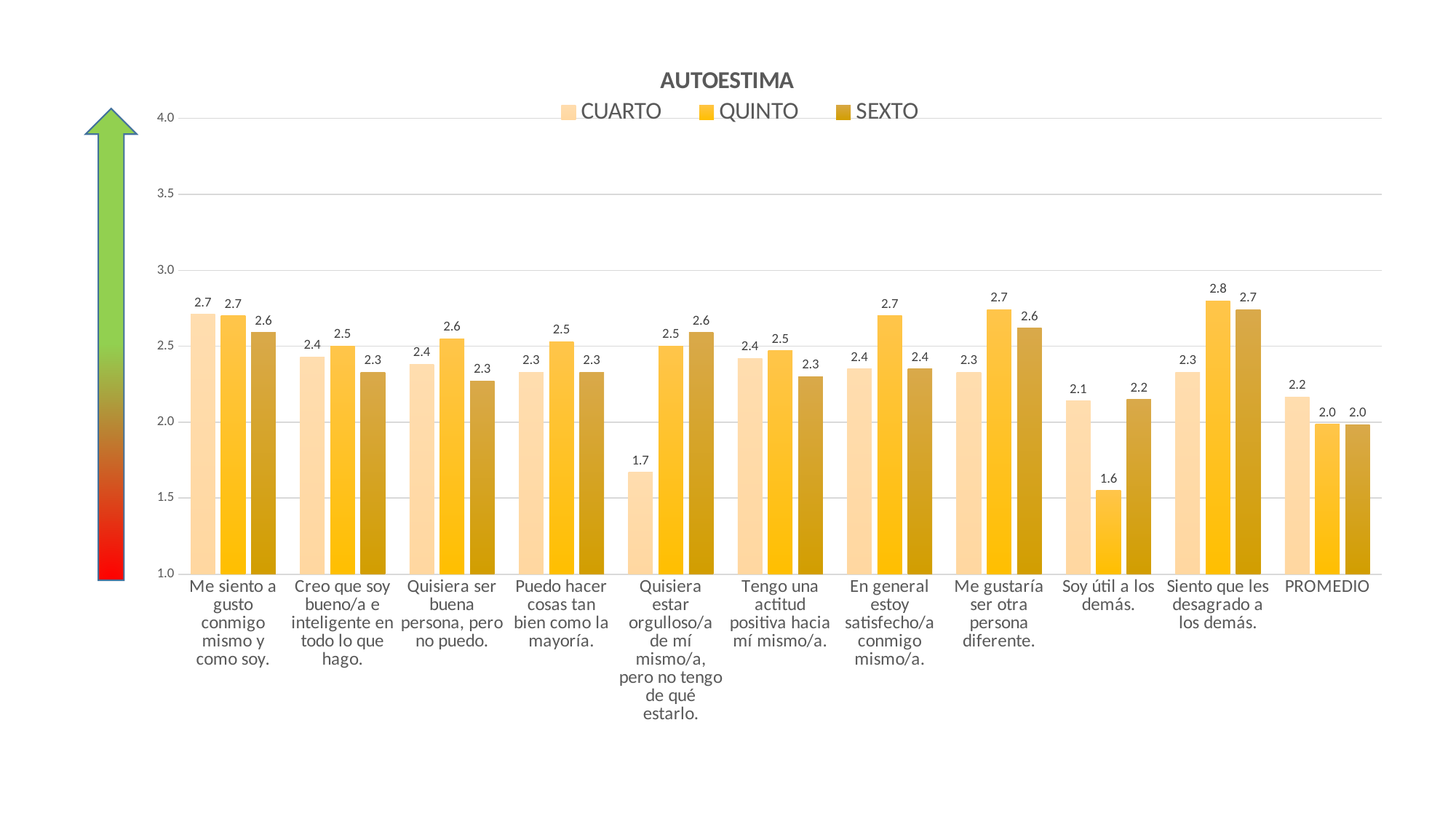
What is the value for QUINTO in the category "Soy útil a los demás."? 1.6 In the category "Me gustaría ser otra persona diferente.", which series has the larger value, CUARTO or QUINTO? QUINTO What is the value for SEXTO in the PROMEDIO category? 2.0 What is the value for QUINTO in the category "Siento que les desagrado a los demás."? 2.8 In which category does the QUINTO series reach its highest value? Siento que les desagrado a los demás. What kind of chart is shown on the slide? Bar chart What is the value for CUARTO in the category "Quisiera estar orgulloso/a de mí mismo/a, pero no tengo de qué estarlo."? 1.7 How many series does the legend list? 3 In which category does the QUINTO series have its lowest value? Soy útil a los demás. How many categories are shown on the x axis? 11 What is the title of the chart? AUTOESTIMA What is the difference between the QUINTO and CUARTO values in the category "Quisiera estar orgulloso/a de mí mismo/a, pero no tengo de qué estarlo."? 0.8